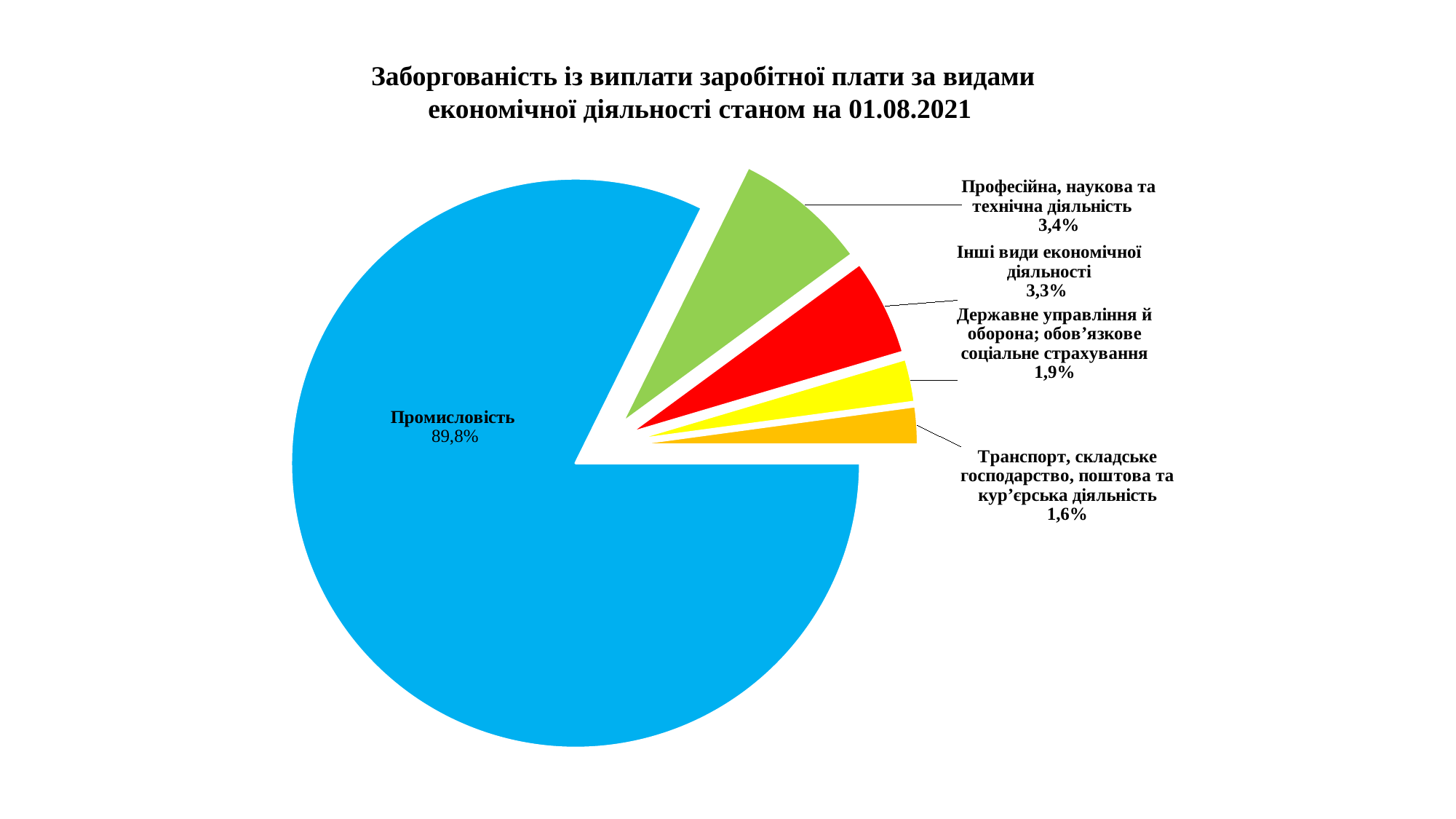
What colour is the slice for Промисловість? Blue What kind of chart is shown on the slide? Pie chart What is the value shown for Професійна, наукова та технічна діяльність? 3,4% What is the value shown for Інші види економічної діяльності? 3,3% Which is larger: the share for Державне управління й оборона; обов’язкове соціальне страхування or the share for Транспорт, складське господарство, поштова та кур’єрська діяльність? Державне управління й оборона; обов’язкове соціальне страхування What share of the pie does Промисловість account for? 89,8% What is the difference between the shares of Професійна, наукова та технічна діяльність and Транспорт, складське господарство, поштова та кур’єрська діяльність? 1,8% What is the value shown for Державне управління й оборона; обов’язкове соціальне страхування? 1,9% Which category has the largest share of the pie? Промисловість Which category has the smallest share of the pie? Транспорт, складське господарство, поштова та кур’єрська діяльність How many categories are shown in the pie chart? 5 What is the value shown for Транспорт, складське господарство, поштова та кур’єрська діяльність? 1,6%